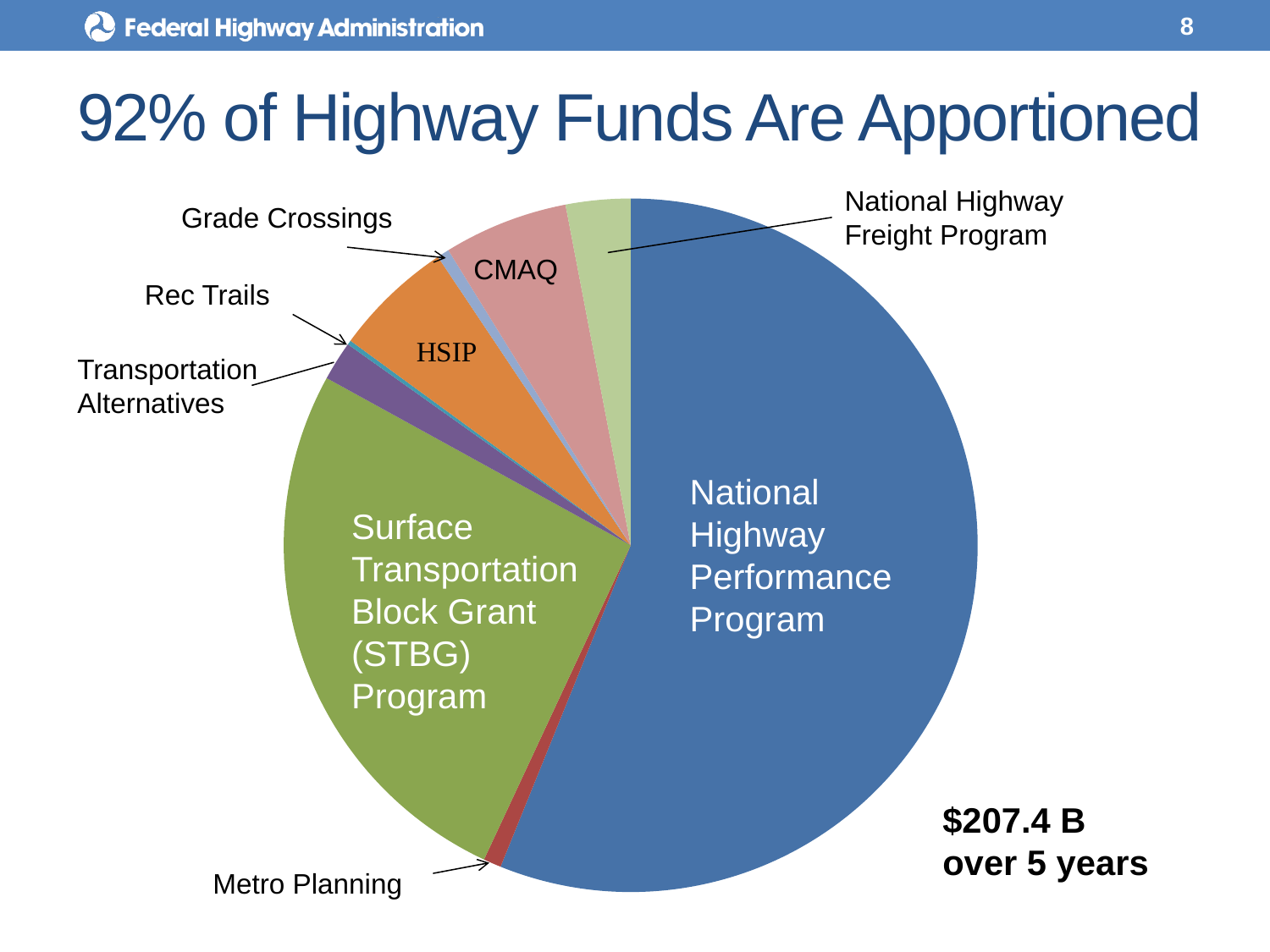
What kind of chart is shown on the slide? Pie chart Which slice is larger: National Highway Freight Program or Grade Crossings? National Highway Freight Program How many slices (programs) does the pie chart show? 9 Which slice is larger: HSIP or Transportation Alternatives? HSIP Which slice is larger: National Highway Performance Program or Surface Transportation Block Grant (STBG) Program? National Highway Performance Program What total amount is stated next to the pie chart? $207.4 B over 5 years Which program has the largest slice of the pie chart? National Highway Performance Program What is the title of the slide containing the pie chart? 92% of Highway Funds Are Apportioned